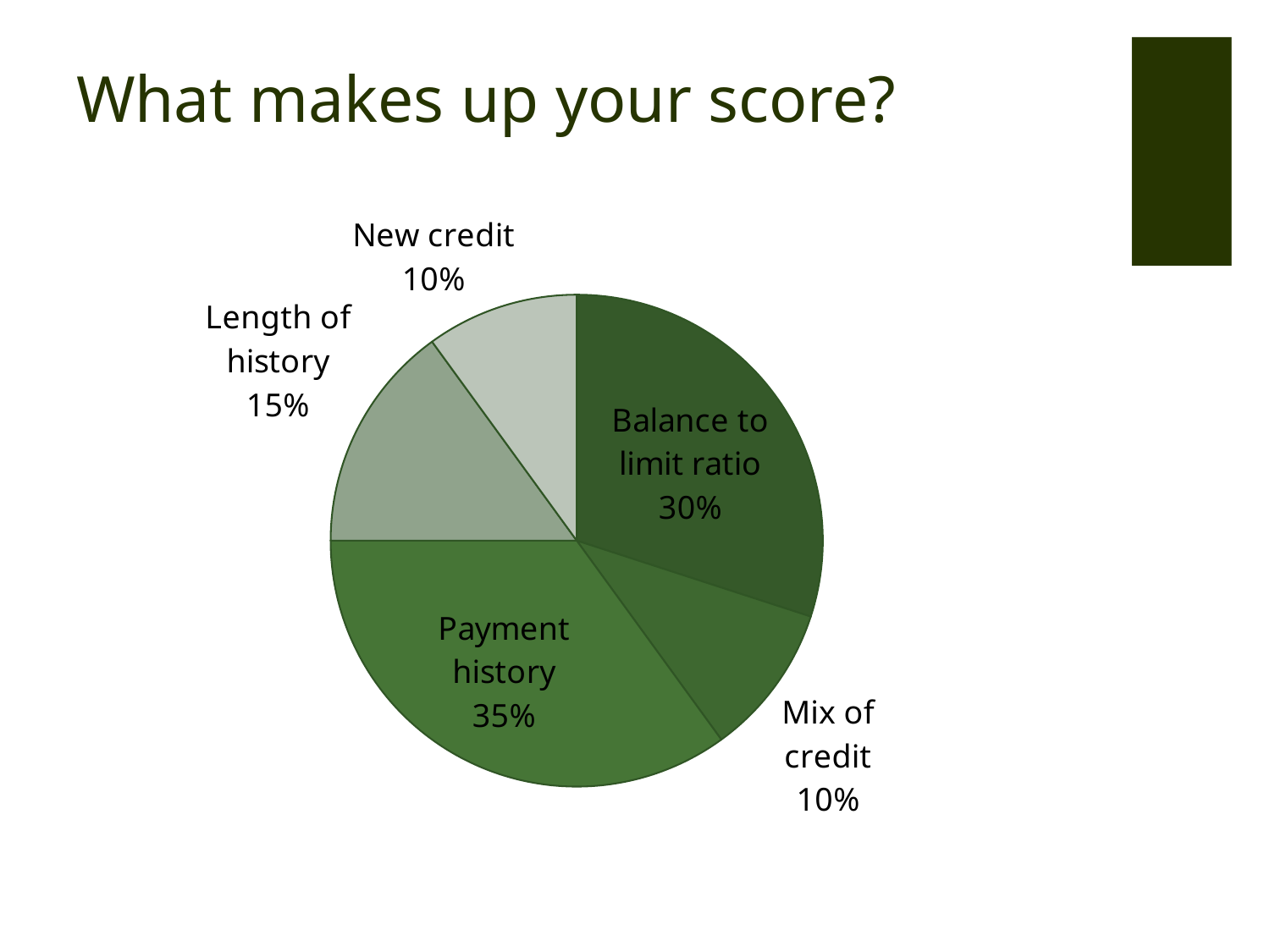
Which two slices have the same share of 10%? New credit and Mix of credit What is the title of the slide containing the pie chart? What makes up your score? What share of the score is Payment history? 35% What share of the score is Length of history? 15% Which slice of the pie is the largest? Payment history Which is larger, Length of history or Mix of credit? Length of history What kind of chart is shown on the slide? Pie chart What is the difference between the Payment history share and the Balance to limit ratio share? 5% How many slices does the pie chart have? 5 What is the combined share of Payment history and Balance to limit ratio? 65% What share of the score is New credit? 10%